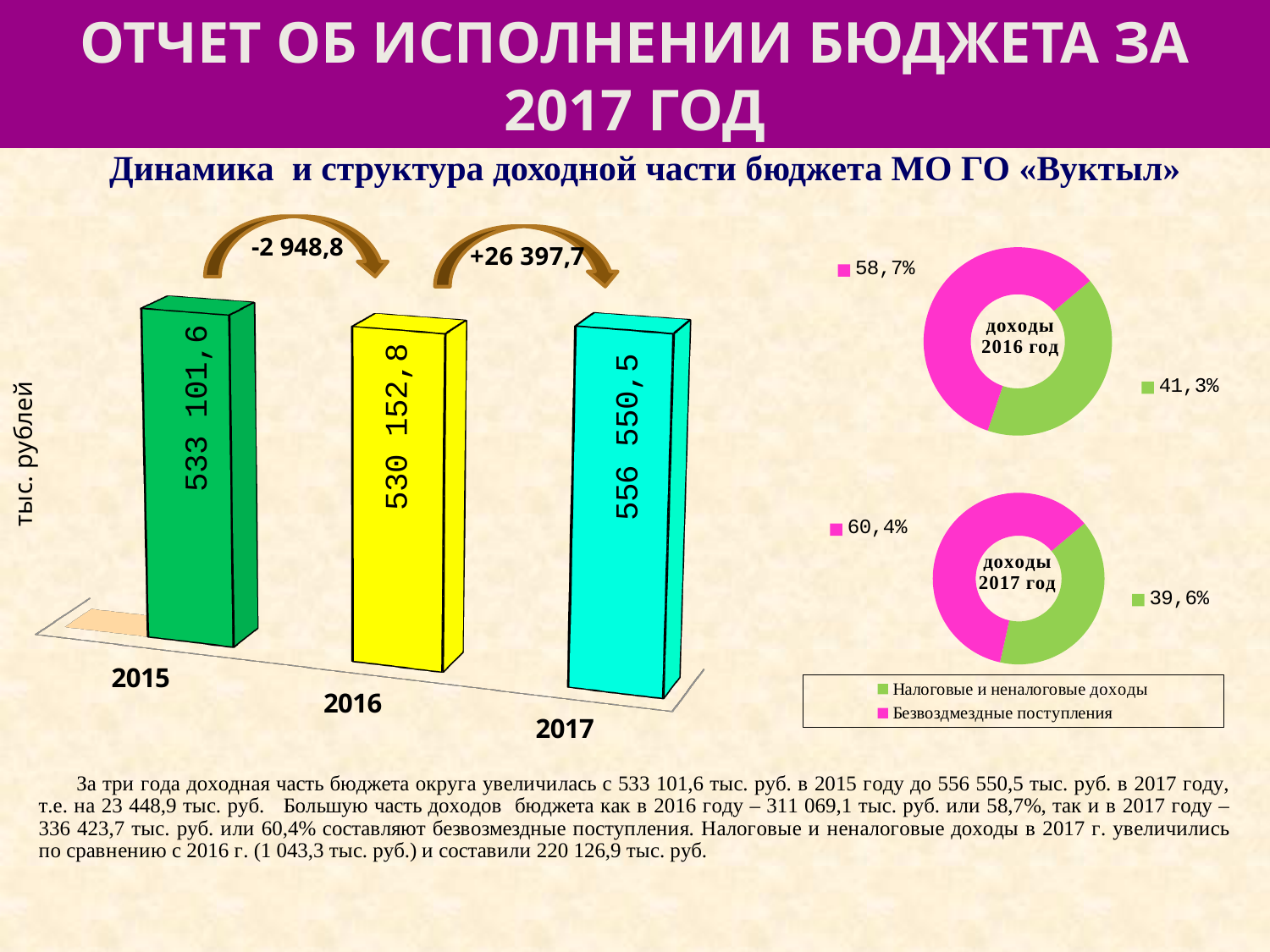
In the bar chart on the left, which year has the highest value? 2017 In the bar chart on the left, how many years are shown? 3 In the bar chart on the left, what is the difference between the 2015 value and the 2016 value? 2 948,8 In the bar chart on the left, what is the value for 2016? 530 152,8 In the bar chart on the left, which year has the lowest value? 2016 In the bar chart on the left, what is the difference between the 2017 value and the 2016 value? 26 397,7 How many series does the legend of the donut charts list? 2 In the bar chart on the left, what is the value for 2017? 556 550,5 In the donut chart labelled «доходы 2016 год», what share is Безвозмездные поступления? 58,7% In the donut chart labelled «доходы 2017 год», what share is Налоговые и неналоговые доходы? 39,6% What type of chart is the chart on the left of the slide? Bar chart In the bar chart on the left, what is the value for 2015? 533 101,6